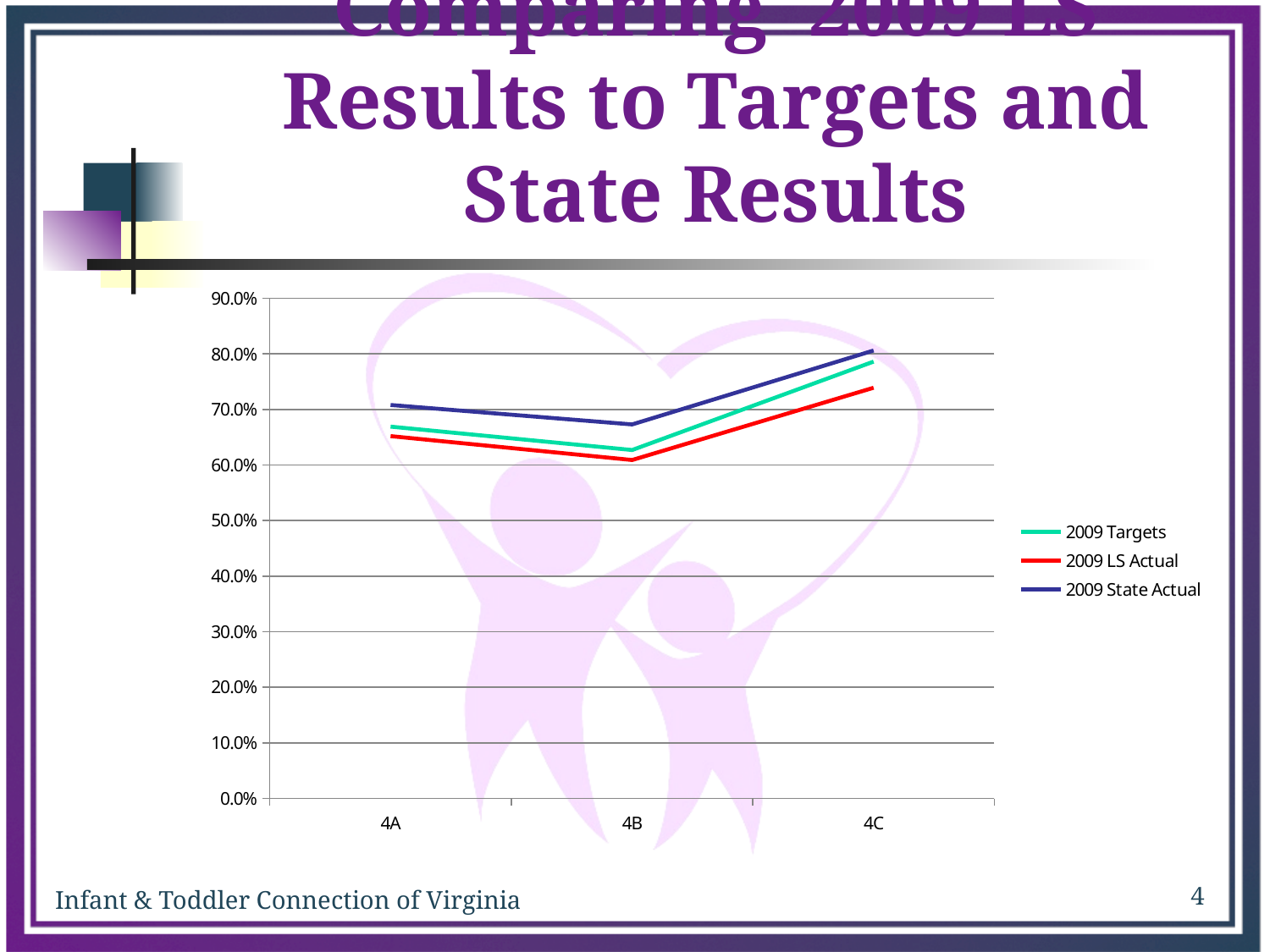
Is the value for 2009 Targets at 4C greater or less than 70.0%? greater Is the value for 2009 Targets at 4B greater or less than 60.0%? greater Which category has the lowest value for 2009 Targets? 4B At 4B, which is larger: 2009 State Actual or 2009 LS Actual? 2009 State Actual How many series does the legend list? 3 Do the values for 2009 State Actual rise or fall from 4B to 4C? rise Which category has the highest value for 2009 LS Actual? 4C How many categories are shown on the x axis? 3 What kind of chart is shown on the slide? line chart What colour is the line for 2009 LS Actual? red Is the value for 2009 LS Actual at 4C greater or less than 80.0%? less